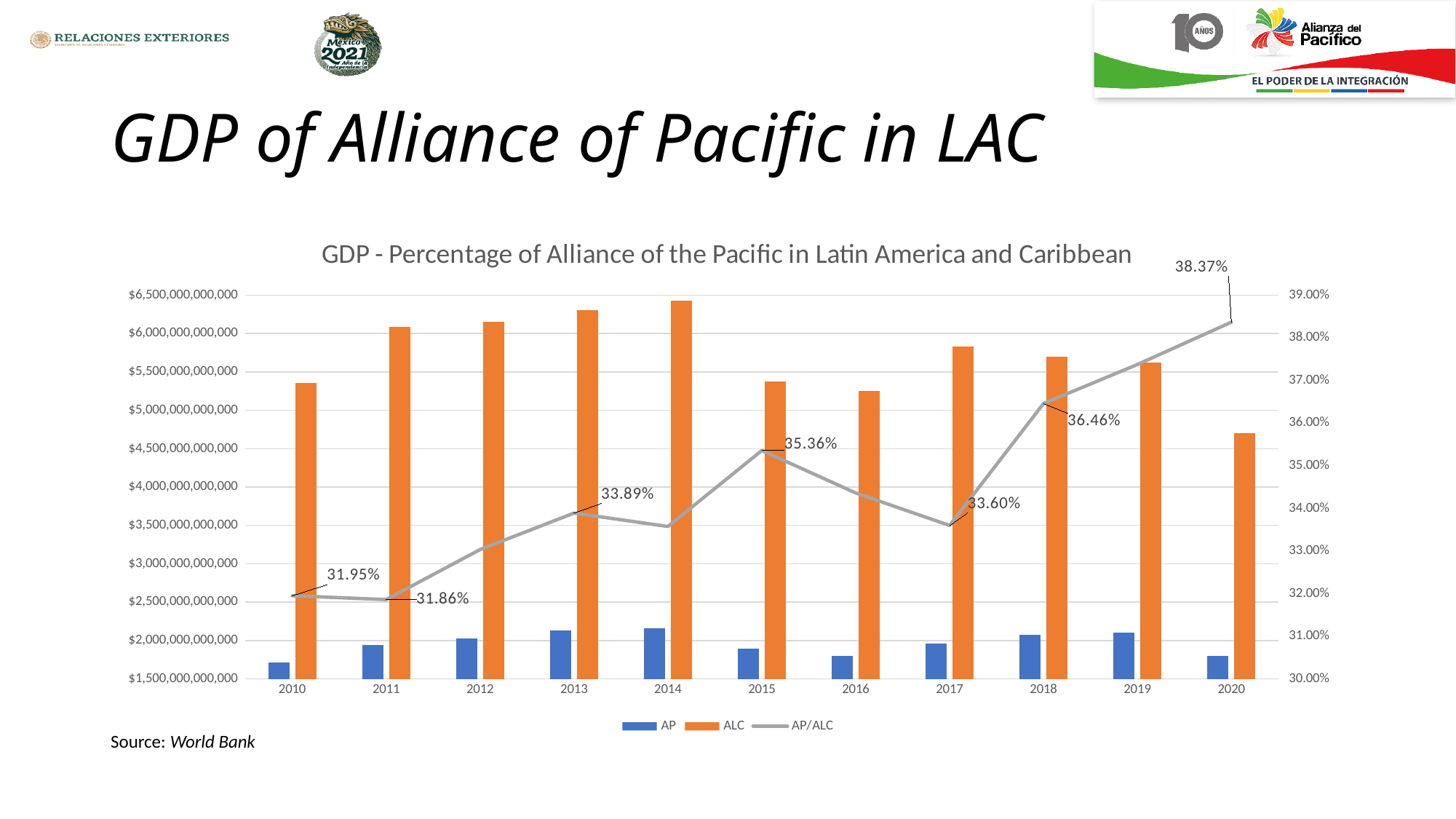
What is the AP/ALC value for 2020? 38.37% By how many percentage points did the AP/ALC value change from 2010 to 2020? 6.42 percentage points How many years are shown on the x axis? 11 In which year is the ALC bar the lowest? 2020 In which year is the ALC bar the highest? 2014 How many series does the legend list? 3 Which is larger, the ALC value for 2011 or for 2016? 2011 What is the AP/ALC value for 2015? 35.36% Is the ALC value for 2020 greater or less than $5,000,000,000,000? less What is the difference between the AP/ALC values for 2018 and 2017? 2.86 percentage points What is the AP/ALC value for 2010? 31.95% Is the ALC value for 2014 greater or less than $6,000,000,000,000? greater